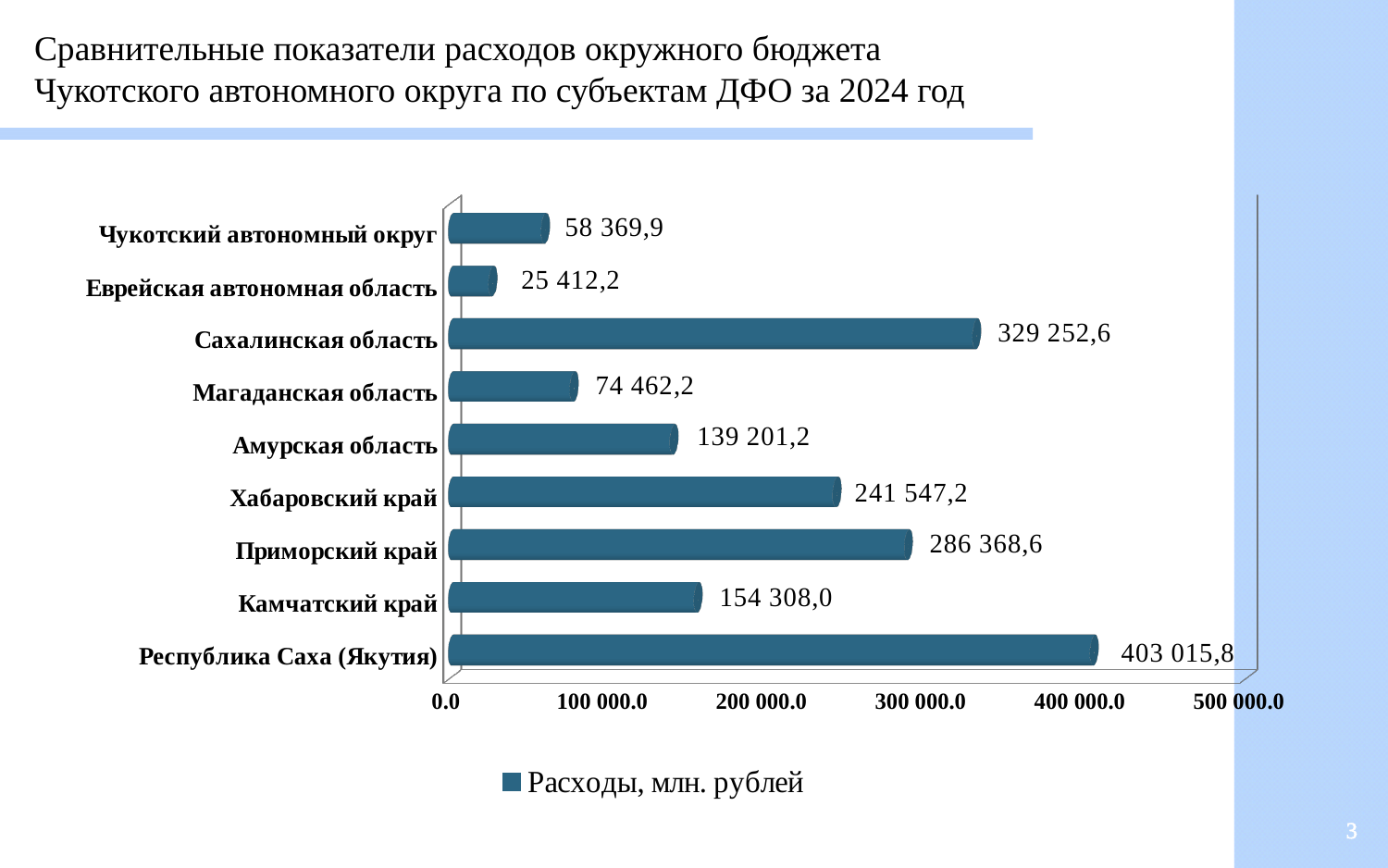
What is the difference between the values for Республика Саха (Якутия) and Чукотский автономный округ? 344 645,9 Which region has the highest value? Республика Саха (Якутия) What is the value for Хабаровский край? 241 547,2 How many series does the legend list? 1 What is the value for Сахалинская область? 329 252,6 Is the value for Магаданская область greater or less than 100 000.0? less What is the difference between the values for Сахалинская область and Приморский край? 42 884,0 Which region has the lowest value? Еврейская автономная область What kind of chart is shown on the slide? bar chart What is the value for Чукотский автономный округ? 58 369,9 Which is larger, the value for Камчатский край or the value for Амурская область? Камчатский край How many regions are shown in the chart? 9